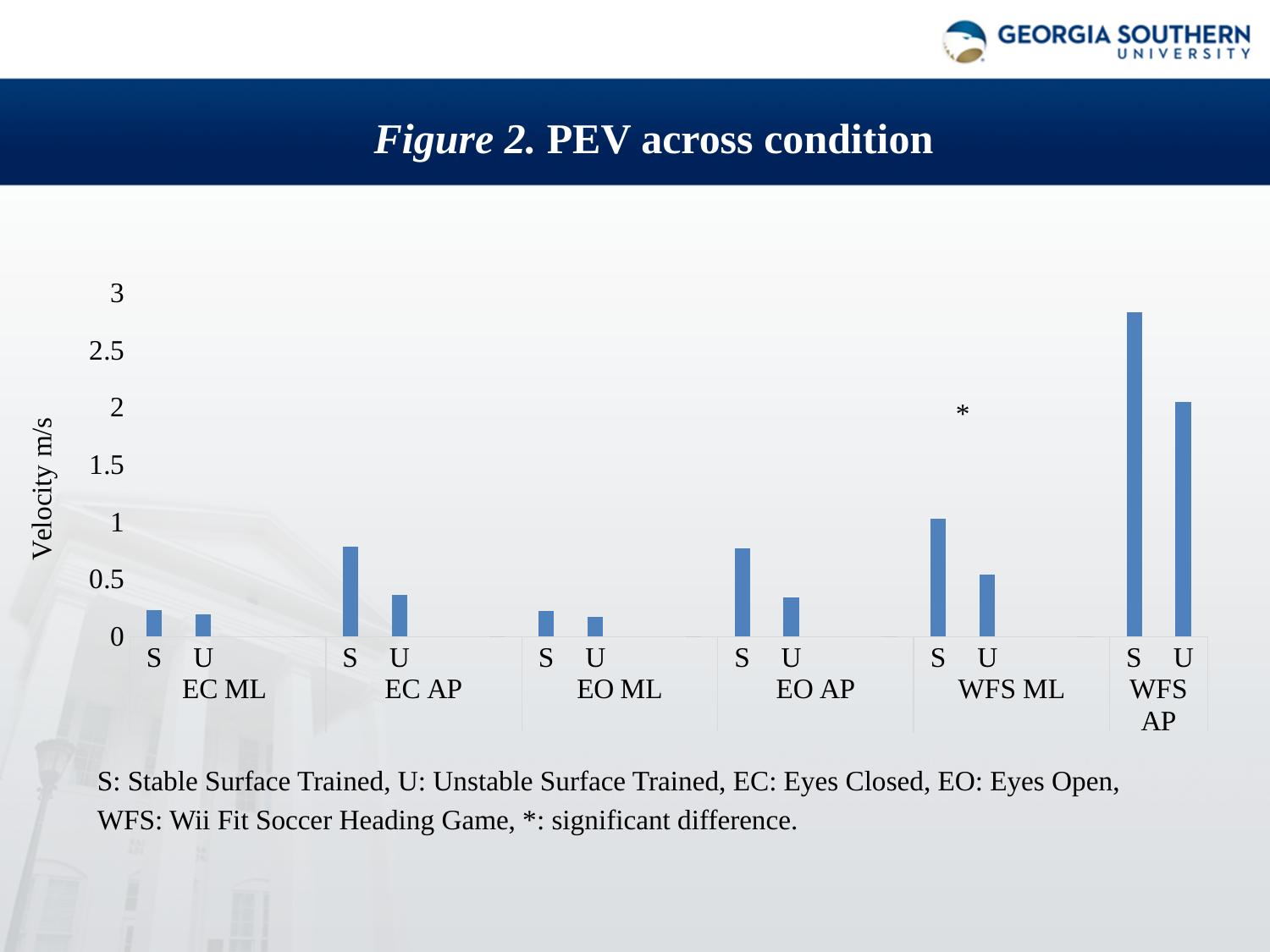
What kind of chart is shown on the slide? bar chart In the WFS AP group, which is larger, S or U? S Is the value for S in WFS AP greater or less than 2.5? greater Is the value for S in EC AP greater or less than 1? less Is the value for U in EO AP greater or less than 0.5? less How many bars are plotted in the chart in total? 12 How many condition groups are shown along the x axis? 6 In the WFS ML group, which is larger, S or U? S What is the label on the y axis of the chart? Velocity m/s Which bar has the highest velocity in the chart? S in WFS AP